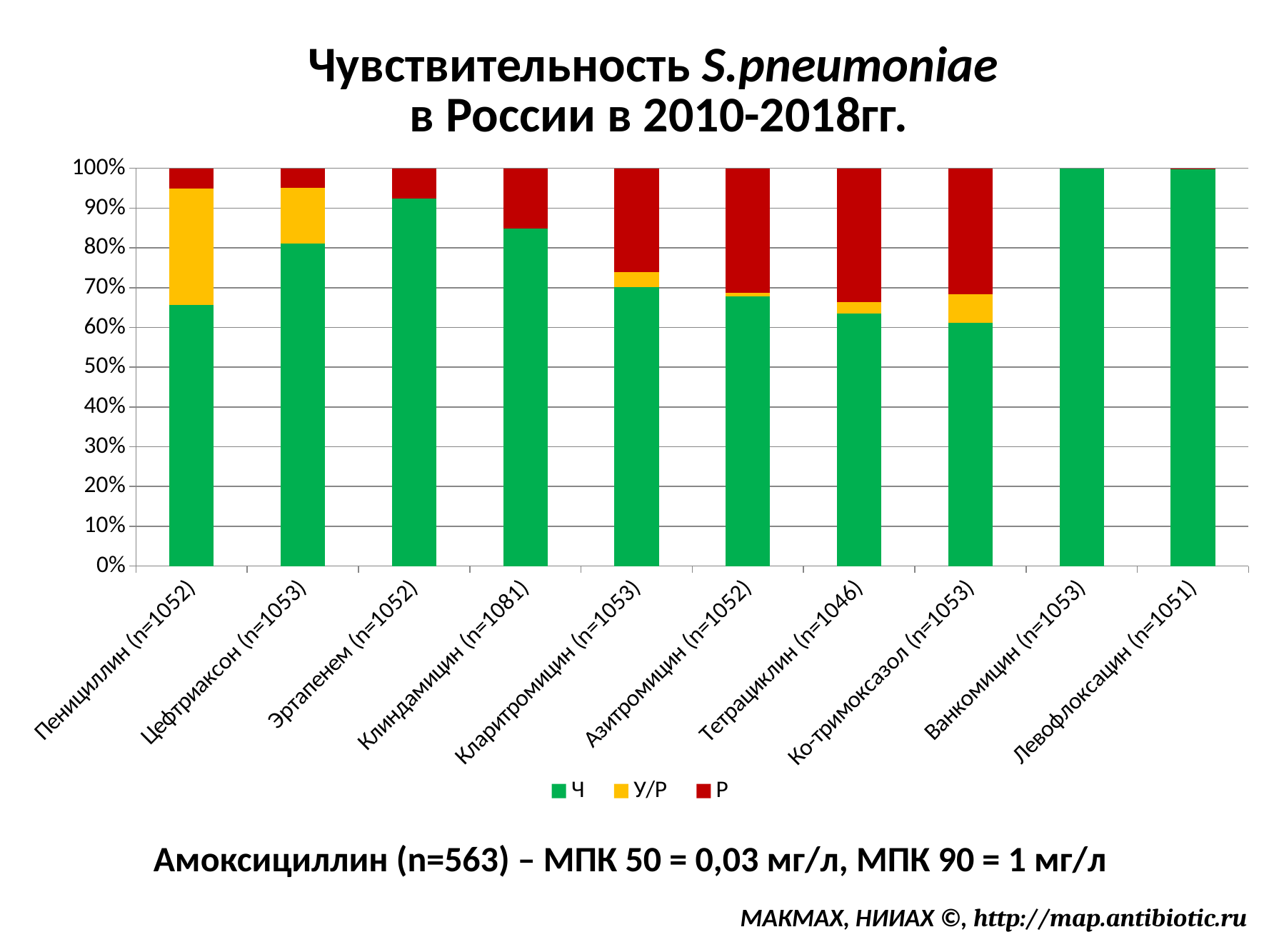
Is the Ч (green) value for Ко-тримоксазол (n=1053) greater or less than 70%? less What is the title of the chart? Чувствительность S.pneumoniae в России в 2010-2018гг. Is the Ч (green) value for Пенициллин (n=1052) greater or less than 70%? less Is the Ч (green) value for Клиндамицин (n=1081) greater or less than 80%? greater How many series does the chart legend list? 3 Which series are listed in the chart legend? Ч, У/Р, Р Which antibiotic has the largest У/Р (yellow) segment? Пенициллин (n=1052) How many antibiotics (categories) are shown on the x axis of the chart? 10 What kind of chart is shown on the slide? Stacked bar chart Which has a larger Ч (green) value: Эртапенем (n=1052) or Клиндамицин (n=1081)? Эртапенем (n=1052) Which has a larger Ч (green) value: Цефтриаксон (n=1053) or Пенициллин (n=1052)? Цефтриаксон (n=1053)